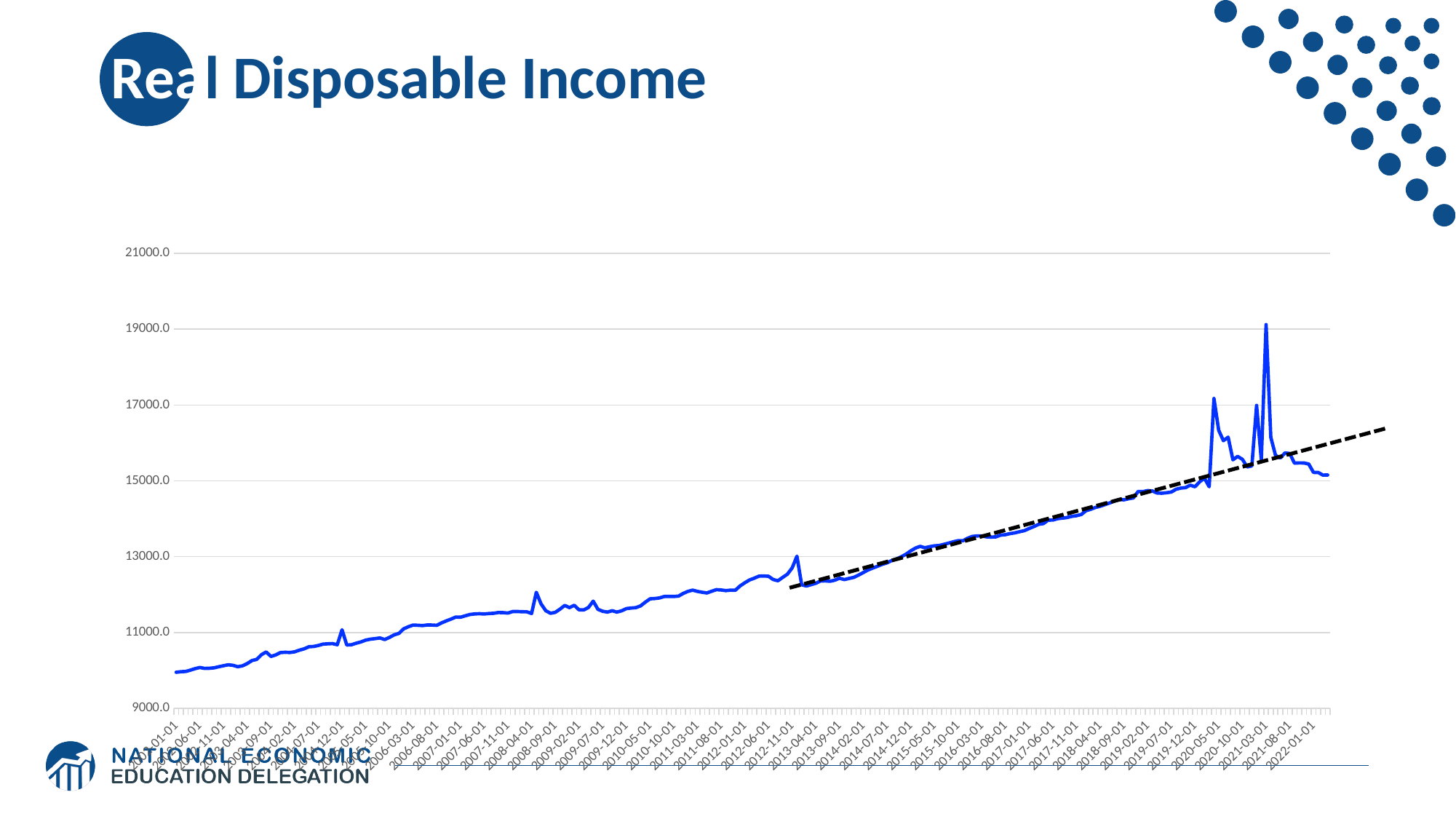
Is the highest point of the series greater or less than 17000? greater Is the value at 2022-01-01 greater or less than 17000? less What is the title of the chart? Real Disposable Income Overall, does the plotted series rise or fall from 2002 to 2022? rises Which is larger, the value at 2008-04-01 or the value at 2016-08-01? 2016-08-01 Is the value at 2019-12-01 greater or less than 17000? less Which is larger, the value at 2002-01-01 or the value at 2022-01-01? 2022-01-01 What is the highest value shown on the vertical axis? 21000.0 What kind of chart is shown on the slide? line chart